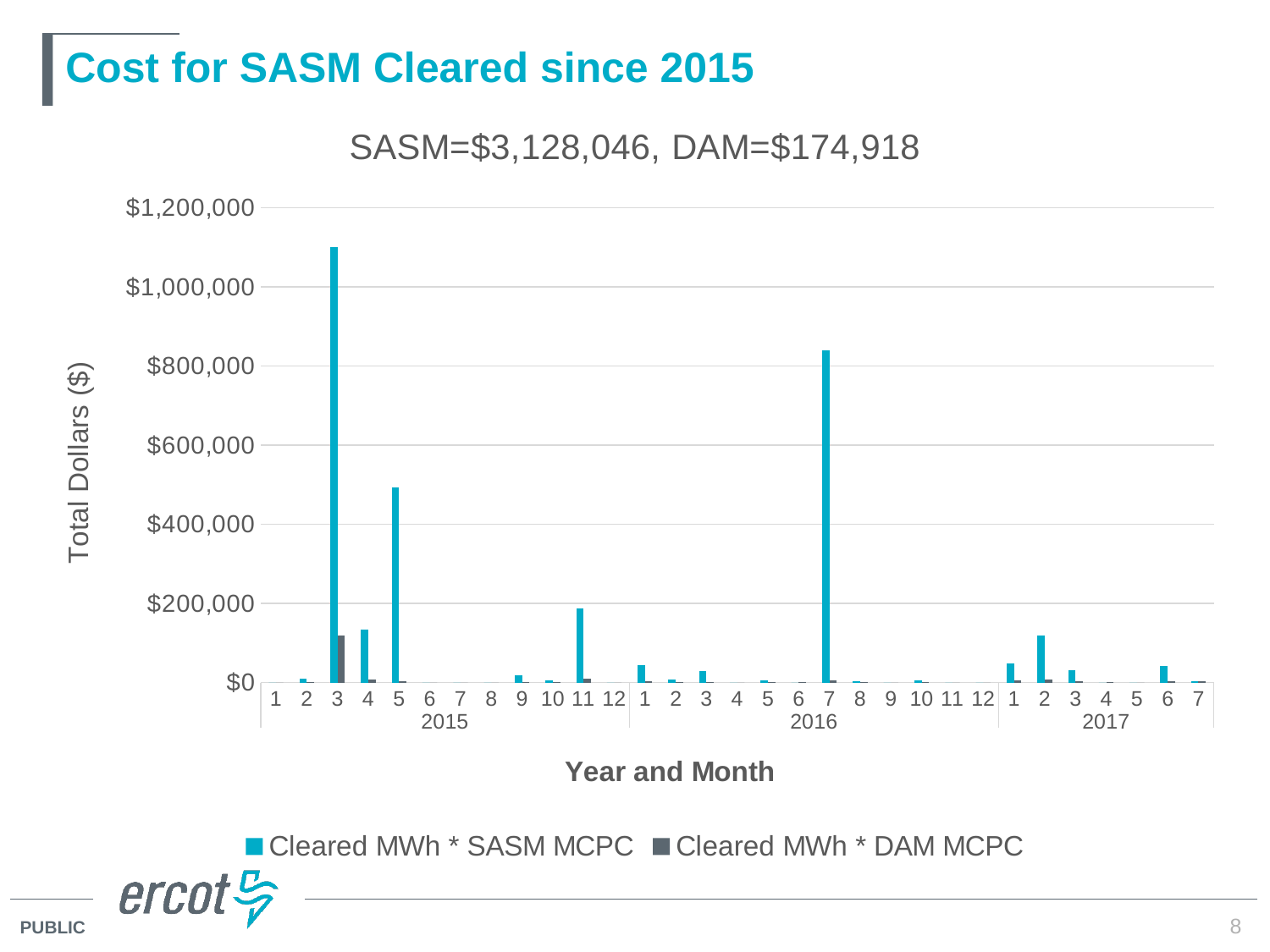
How many year-month categories are shown on the x axis? 31 What kind of chart is shown on the slide? bar chart How many series does the legend list? 2 Is the Cleared MWh * SASM MCPC value for month 7 of 2016 greater or less than $800,000? greater According to the chart subtitle, what is the total DAM cost? $174,918 What is the title of the chart on the slide? SASM=$3,128,046, DAM=$174,918 According to the chart subtitle, what is the total SASM cost? $3,128,046 Is the Cleared MWh * SASM MCPC value for month 5 of 2015 greater or less than $600,000? less What are the two series named in the legend? Cleared MWh * SASM MCPC and Cleared MWh * DAM MCPC In which year and month is the Cleared MWh * SASM MCPC value highest? March 2015 (2015, month 3) Which is larger, the Cleared MWh * SASM MCPC value for month 5 of 2015 or for month 11 of 2015? month 5 of 2015 Is the Cleared MWh * SASM MCPC value for month 3 of 2015 greater or less than $1,000,000? greater